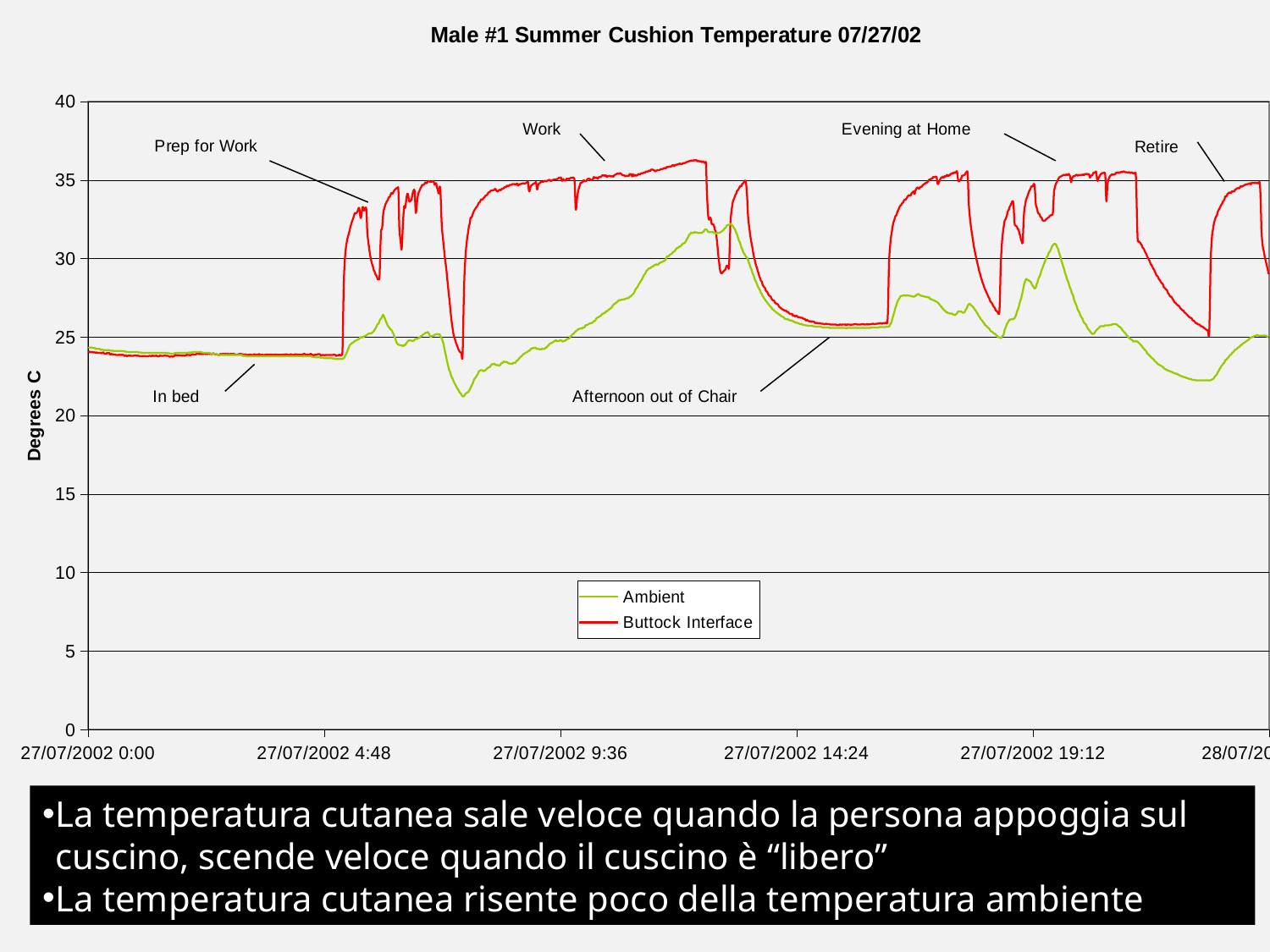
Which series reaches a higher peak, Ambient or Buttock Interface? Buttock Interface Between the 'Work' period and the 'Afternoon out of Chair' period, does the Buttock Interface temperature rise or fall? fall Which series is drawn in red? Buttock Interface Is the Buttock Interface value during the 'Evening at Home' period greater or less than 30? greater Is the Ambient value at the 'Afternoon out of Chair' annotation greater or less than 30? less Is the Ambient value during the 'In bed' period greater or less than 30? less How many series does the legend list? 2 Between the 'In bed' period and the 'Prep for Work' period, does the Buttock Interface temperature rise or fall? rise What kind of chart is shown on the slide? line chart What is the title of the chart? Male #1 Summer Cushion Temperature 07/27/02